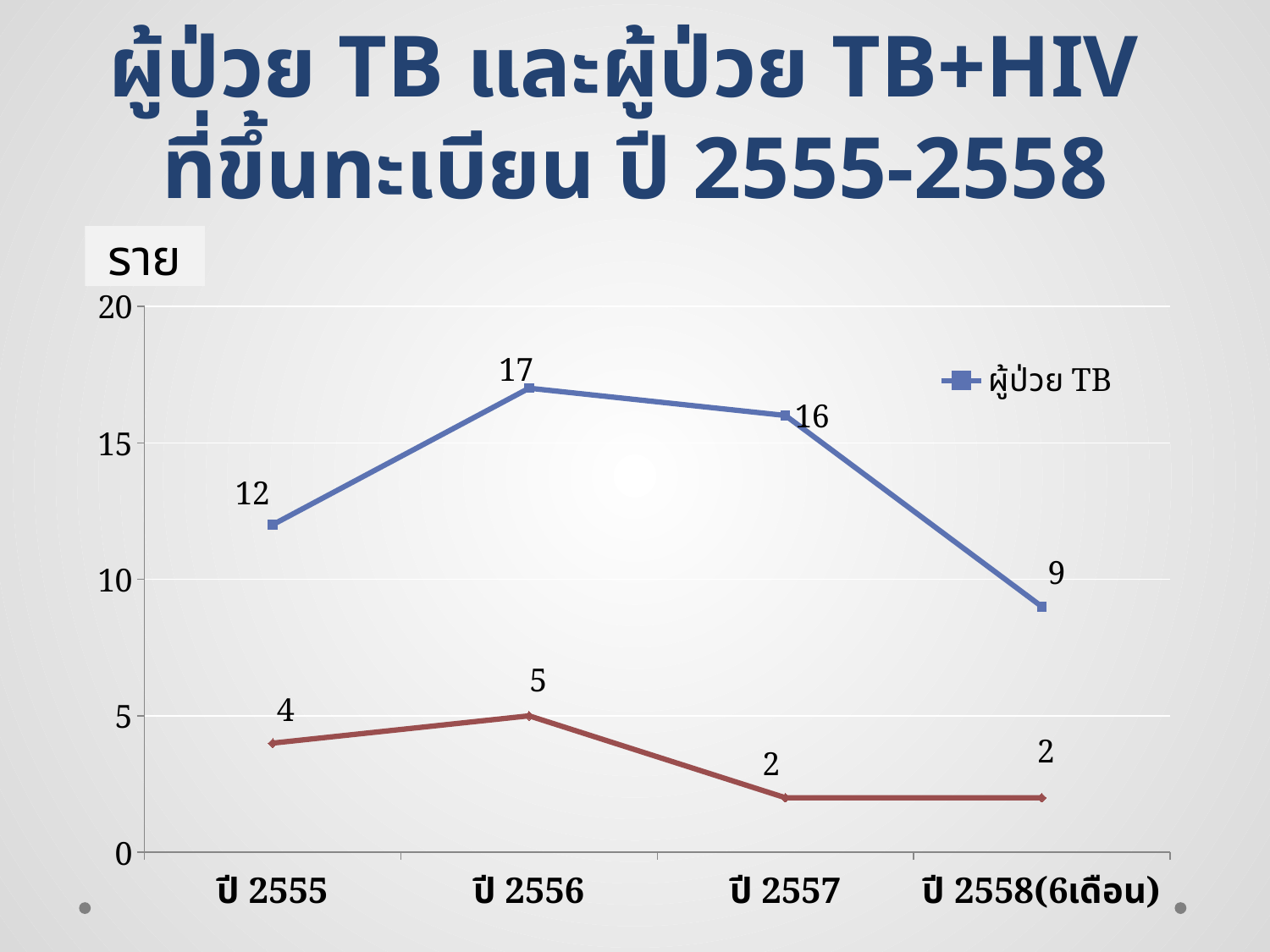
What is the value of ผู้ป่วย TB in ปี 2556? 17 Which is larger for ผู้ป่วย TB: ปี 2555 or ปี 2557? ปี 2557 Does ผู้ป่วย TB rise or fall from ปี 2556 to ปี 2558(6เดือน)? fall In which year is ผู้ป่วย TB lowest? ปี 2558(6เดือน) In which year is ผู้ป่วย TB highest? ปี 2556 What kind of chart is shown on the slide? line chart How many years (categories) are shown on the x axis? 4 What is the difference between the red (lower) line's values in ปี 2556 and ปี 2557? 3 How many series does the legend list? 1 What is the value of the red (lower) line in ปี 2555? 4 What is the value of ผู้ป่วย TB in ปี 2558(6เดือน)? 9 What is the difference between ผู้ป่วย TB in ปี 2556 and in ปี 2558(6เดือน)? 8